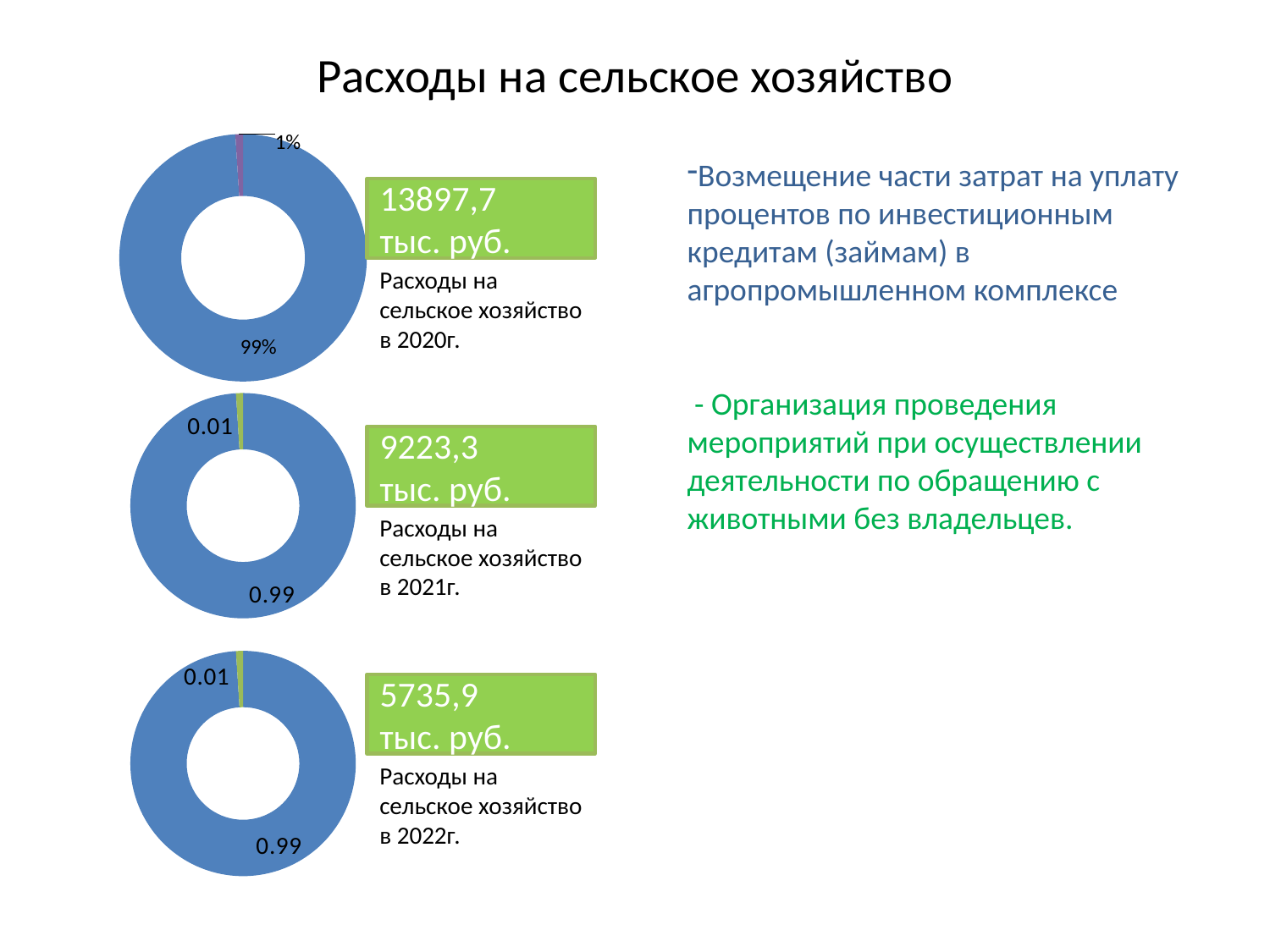
In the middle chart (2021), what label is shown on the large blue slice? 0.99 In the top chart (2020), what label is shown on the large blue slice? 99% How many slices does the top chart (2020) have? 2 In the bottom chart (2022), what label is shown on the small green slice? 0.01 What type of chart is used for the 2020 expenditure on the slide? doughnut chart In the bottom chart (2022), which slice is larger, the blue one or the green one? the blue one How many doughnut charts are shown on the slide? 3 In the bottom chart (2022), what label is shown on the large blue slice? 0.99 In the middle chart (2021), what label is shown on the small green slice? 0.01 What is the title of the slide containing the three doughnut charts? Расходы на сельское хозяйство In the top chart (2020), what is the difference between the two slice labels? 98% In the top chart (2020), what label is shown on the small slice? 1%